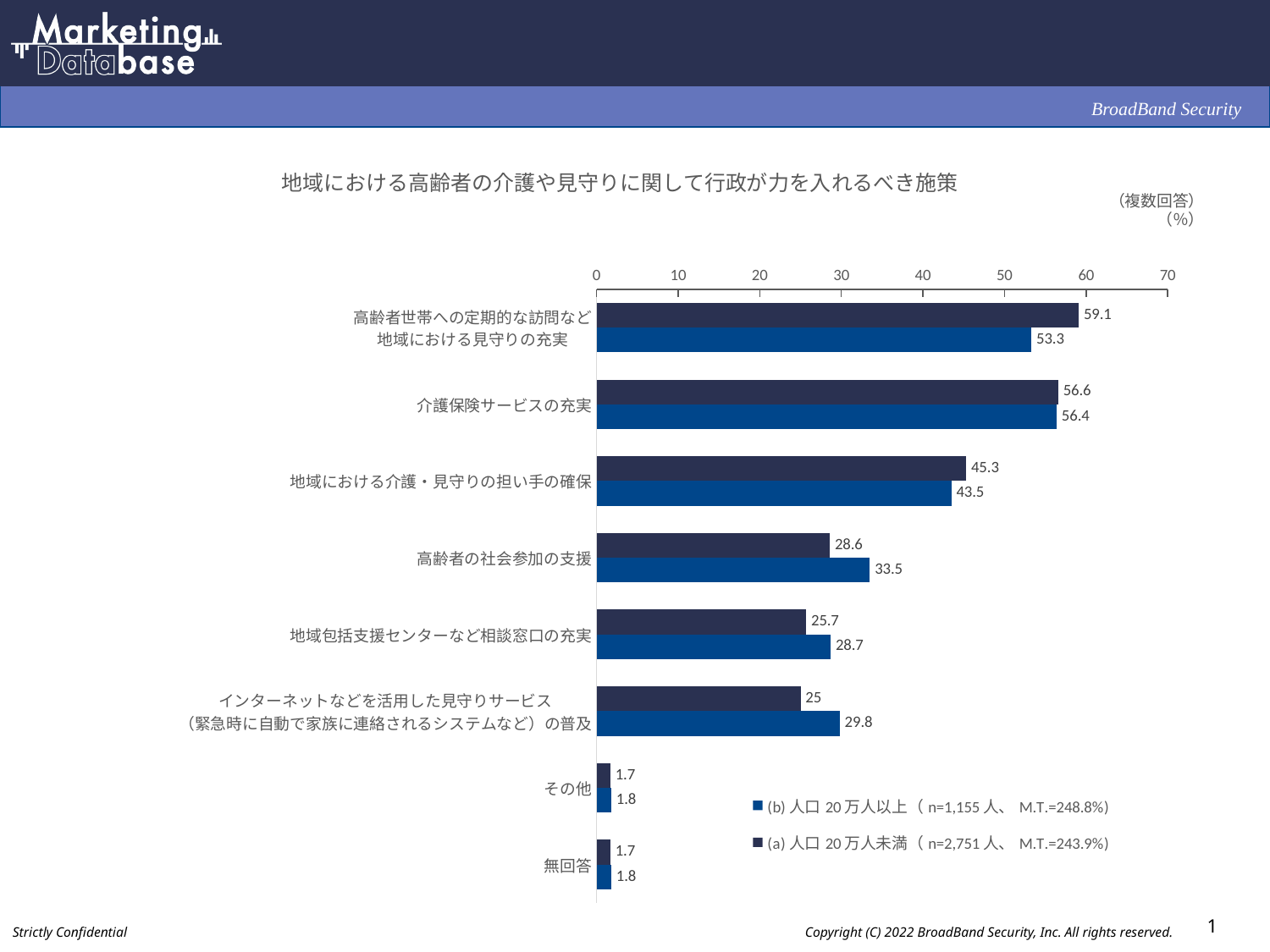
What is the value of the lighter blue bar for インターネットなどを活用した見守りサービス（緊急時に自動で家族に連絡されるシステムなど）の普及? 29.8 How many series does the legend list? 2 What type of chart is shown on the slide? Bar chart Which category has the highest value among the dark navy bars? 高齢者世帯への定期的な訪問など地域における見守りの充実 Is the dark navy bar for 地域における介護・見守りの担い手の確保 greater or less than 40? greater What is the value of the lighter blue bar for 高齢者の社会参加の支援? 33.5 What is the difference between the dark navy bar and the lighter blue bar for 高齢者世帯への定期的な訪問など地域における見守りの充実? 5.8 For 地域包括支援センターなど相談窓口の充実, which bar is larger, the dark navy bar or the lighter blue bar? The lighter blue bar What is the value shown for その他 on the lighter blue bar? 1.8 How many categories are plotted on the chart? 8 What is the title of the chart? 地域における高齢者の介護や見守りに関して行政が力を入れるべき施策 What is the value of the dark navy bar for 介護保険サービスの充実? 56.6